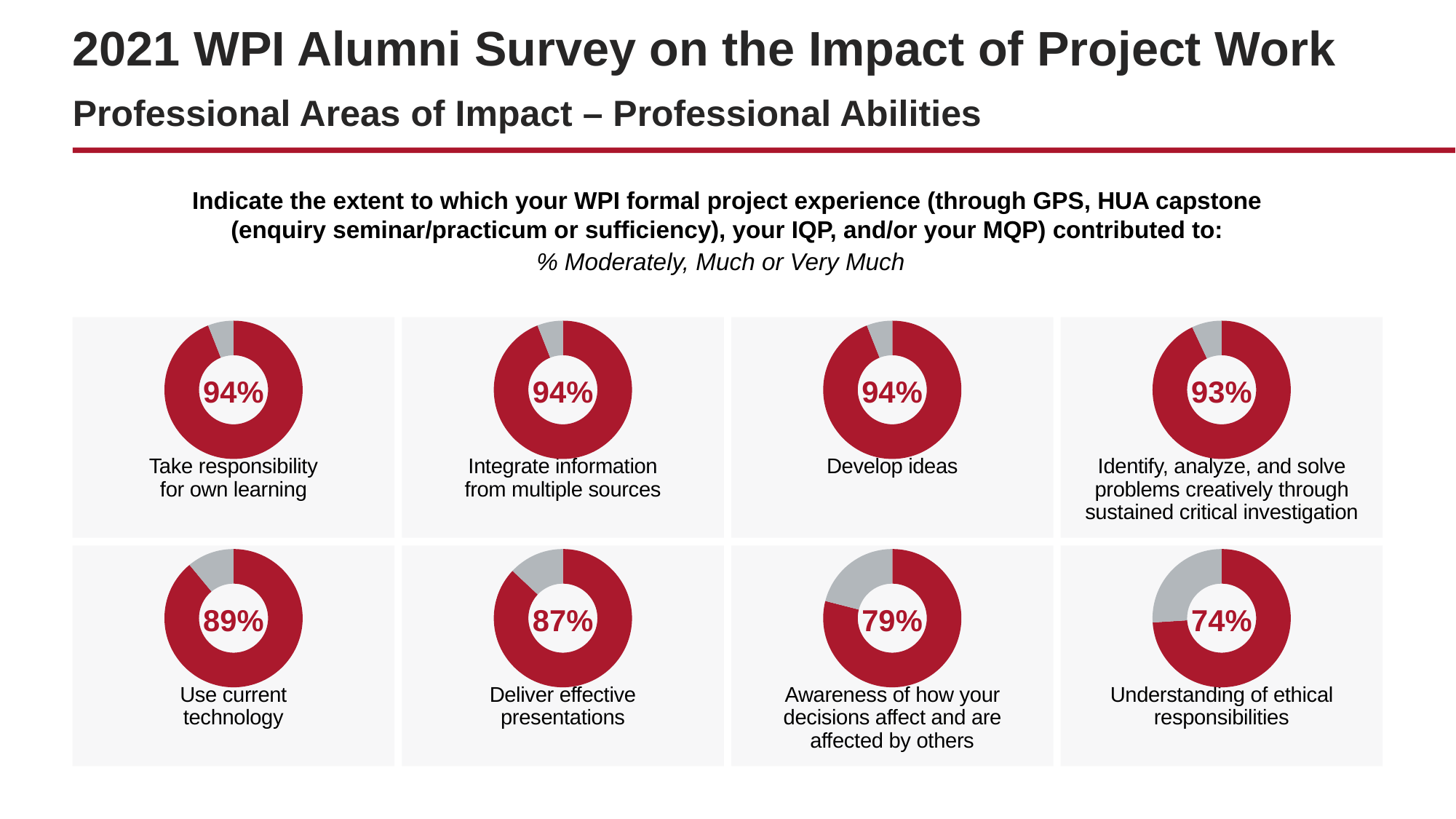
What is the difference in percentage points between the "Develop ideas" chart and the "Awareness of how your decisions affect and are affected by others" chart? 15 What kind of chart is used to display each percentage on the slide? Donut (pie) chart Which professional ability has the lowest percentage among the donut charts on the slide? Understanding of ethical responsibilities Which is larger: the percentage for "Use current technology" or the percentage for "Deliver effective presentations"? Use current technology What colour is used for the filled (percentage) portion of each donut chart? Red What percentage is shown in the donut chart labelled "Take responsibility for own learning"? 94% What percentage is shown in the donut chart labelled "Use current technology"? 89% What percentage is shown in the donut chart labelled "Understanding of ethical responsibilities"? 74% How many donut charts are shown on the slide? 8 How many of the donut charts on the slide show a value of 94%? 3 What percentage is shown in the donut chart labelled "Deliver effective presentations"? 87% What percentage is shown in the donut chart labelled "Identify, analyze, and solve problems creatively through sustained critical investigation"? 93%